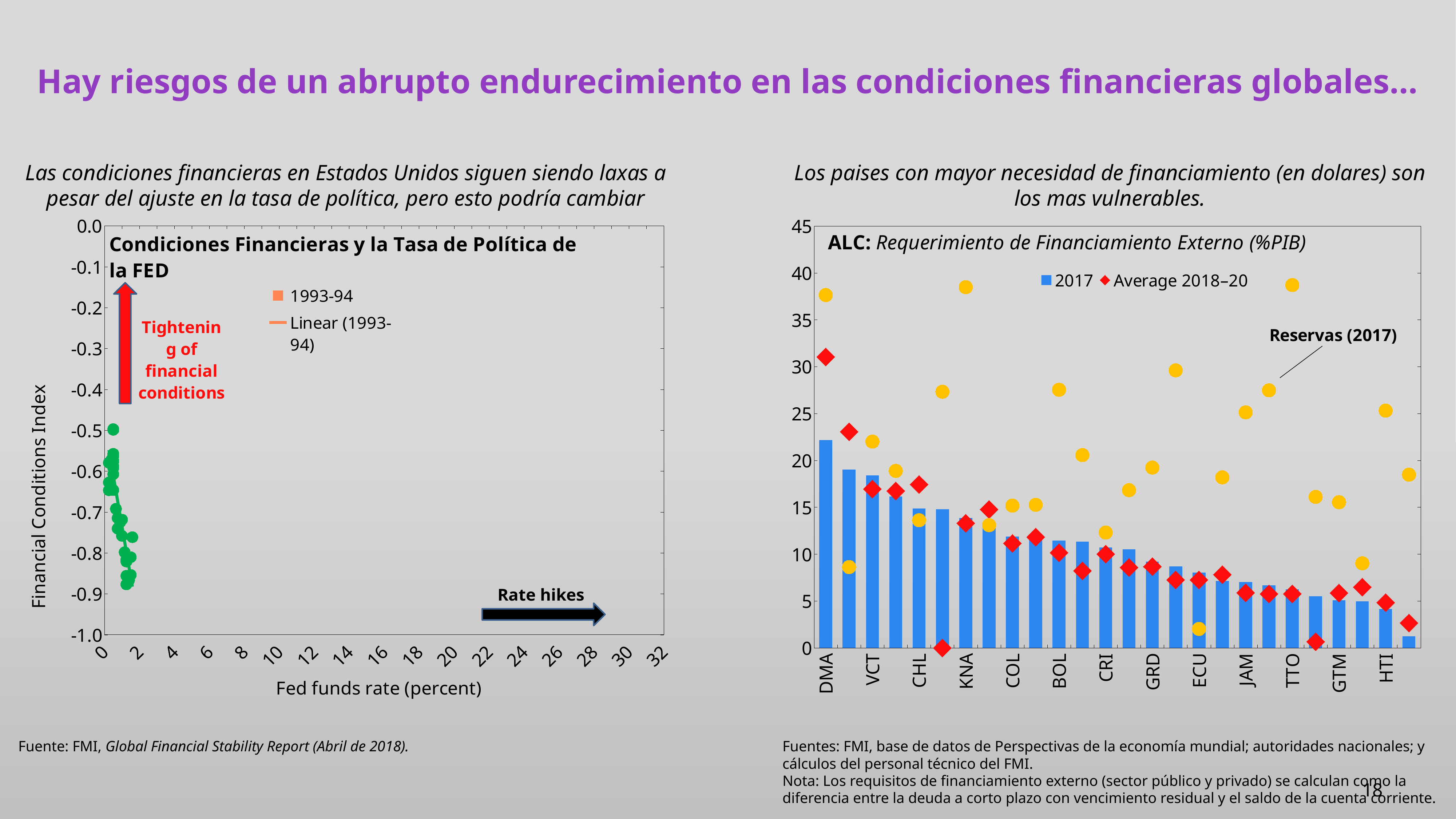
In the left chart, are the plotted points' Fed funds rate values greater or less than 10? less In the right chart, which has a larger 2017 bar, DMA or HTI? DMA In the right chart, how many series does the legend box list? 2 In the right chart, which labeled country has the lowest 2017 bar? HTI In the left chart, what is the label of the x axis? Fed funds rate (percent) What type of chart is the right chart, 'ALC: Requerimiento de Financiamiento Externo (%PIB)'? Bar chart What type of chart is the left chart, 'Condiciones Financieras y la Tasa de Política de la FED'? Scatter plot In the right chart, do the 2017 bars rise or fall from left to right? Fall In the right chart, is the 2017 bar for DMA greater or less than 20? greater In the right chart, is the 2017 bar for HTI greater or less than 5? less In the right chart, which country has the highest 2017 bar? DMA